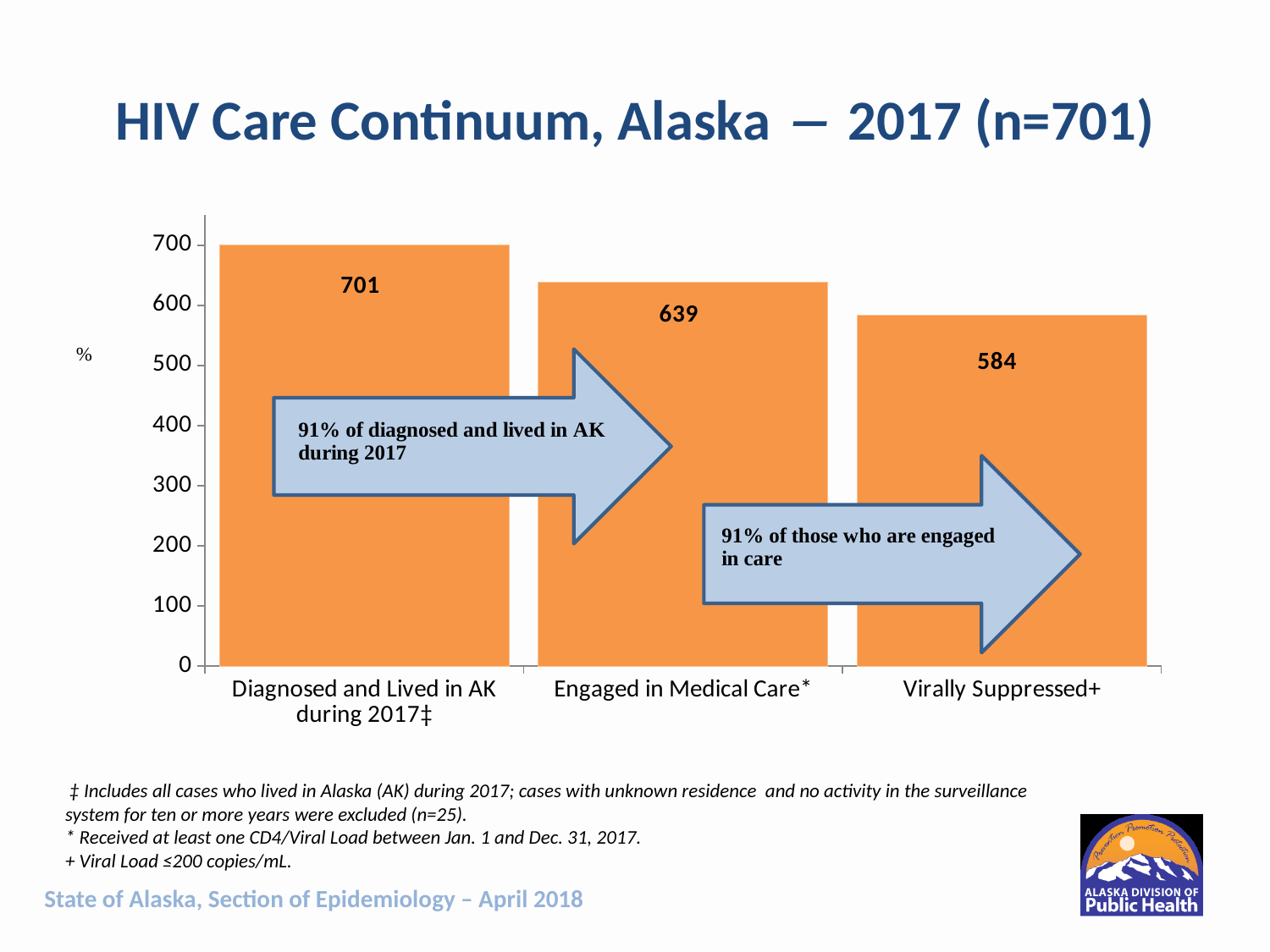
What is the difference between the values for Engaged in Medical Care and Virally Suppressed? 55 What is the value for Diagnosed and Lived in AK during 2017? 701 How many categories are shown in the chart? 3 What is the difference between the values for Diagnosed and Lived in AK during 2017 and Engaged in Medical Care? 62 Do the values rise or fall from left to right along the x axis? fall Which category has the highest value? Diagnosed and Lived in AK during 2017 What kind of chart is shown on the slide? bar chart Which is larger, the value for Engaged in Medical Care or the value for Virally Suppressed? Engaged in Medical Care Which category has the lowest value? Virally Suppressed What is the value for Engaged in Medical Care? 639 What is the value for Virally Suppressed? 584 Is the value for Virally Suppressed greater or less than 600? less